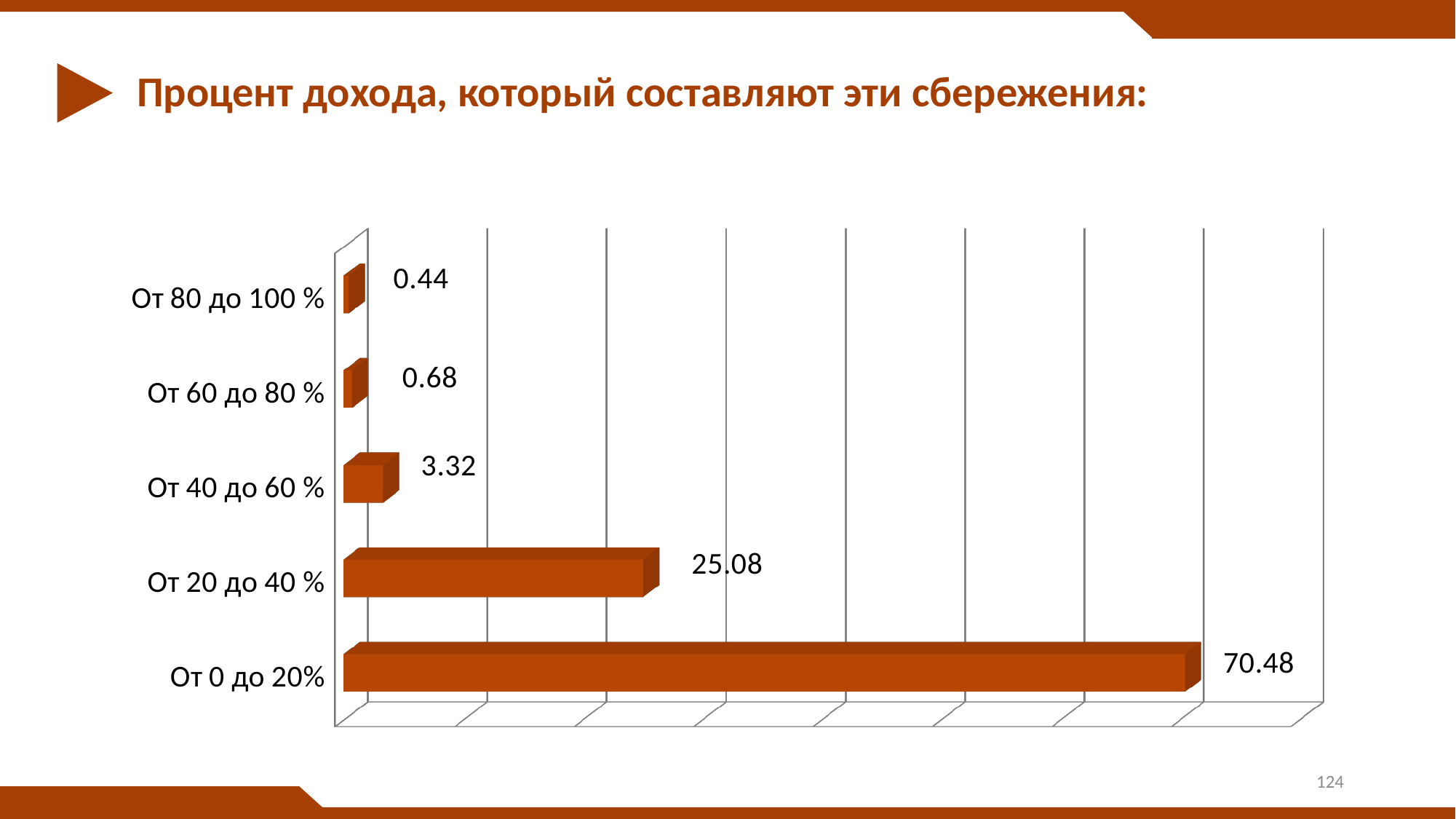
Which category has the highest value? От 0 до 20% What kind of chart is shown on the slide? Bar chart What is the title of the slide above the chart? Процент дохода, который составляют эти сбережения: What is the value for the category 'От 20 до 40 %'? 25.08 What is the value for the category 'От 60 до 80 %'? 0.68 Which category has the lowest value? От 80 до 100 % Which is larger, the value for 'От 40 до 60 %' or the value for 'От 60 до 80 %'? От 40 до 60 % What is the value for the category 'От 40 до 60 %'? 3.32 What is the value for the category 'От 80 до 100 %'? 0.44 What is the difference between the values for 'От 0 до 20%' and 'От 20 до 40 %'? 45.4 What is the value for the category 'От 0 до 20%'? 70.48 How many categories are shown in the chart? 5